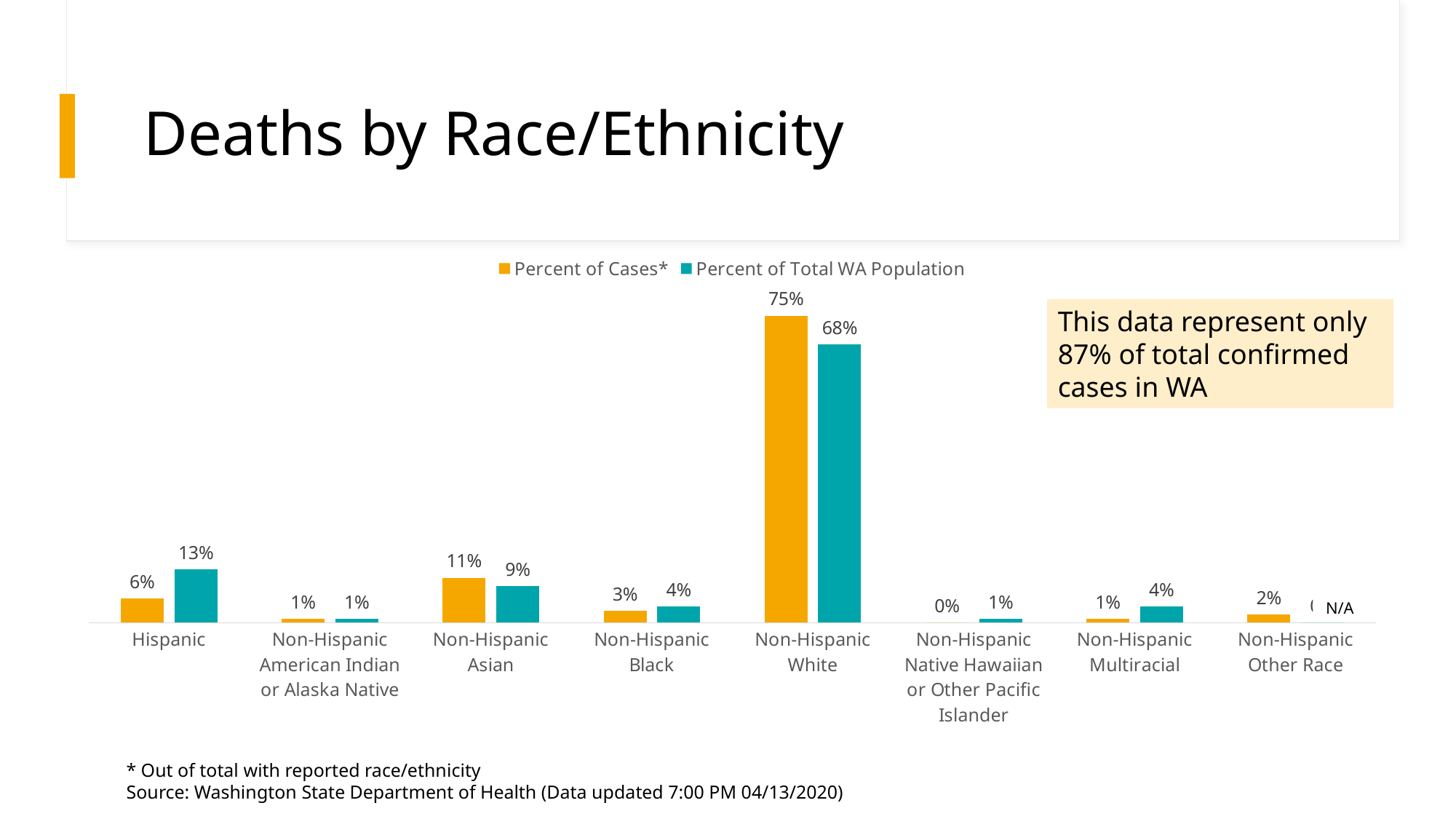
Which category has the lowest Percent of Cases*? Non-Hispanic Native Hawaiian or Other Pacific Islander What is the Percent of Total WA Population for Non-Hispanic Multiracial? 4% What is the difference between Percent of Cases* and Percent of Total WA Population for Non-Hispanic White? 7% What is the Percent of Cases* for Non-Hispanic Asian? 11% What is the difference between Percent of Total WA Population and Percent of Cases* for Hispanic? 7% What kind of chart is shown on the slide? Bar chart Which category has the highest Percent of Cases*? Non-Hispanic White What is the Percent of Cases* for Non-Hispanic White? 75% How many series does the legend list? 2 What is the Percent of Total WA Population for Hispanic? 13% For Non-Hispanic Black, which is larger: Percent of Cases* or Percent of Total WA Population? Percent of Total WA Population How many race/ethnicity categories are shown on the x axis? 8